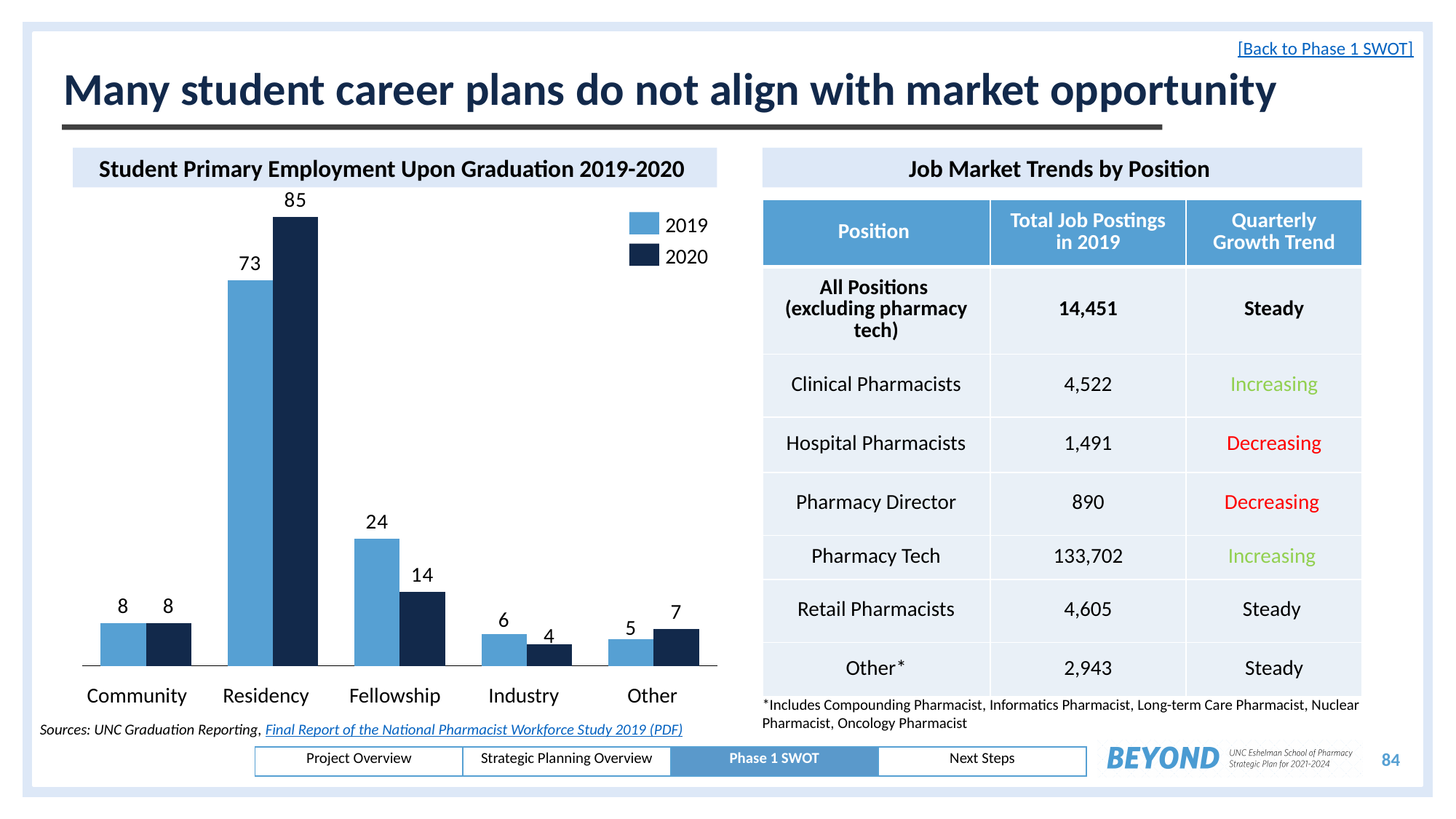
In the Student Primary Employment Upon Graduation chart, what is the difference between the 2019 and 2020 values for Fellowship? 10 Which series in the Student Primary Employment Upon Graduation chart is shown in dark navy? 2020 Which category has the highest 2019 value in the Student Primary Employment Upon Graduation chart? Residency How many series does the legend of the Student Primary Employment Upon Graduation chart list? 2 What kind of chart is the Student Primary Employment Upon Graduation chart? bar chart How many categories are shown on the x axis of the Student Primary Employment Upon Graduation chart? 5 What is the 2019 value for Fellowship in the Student Primary Employment Upon Graduation chart? 24 In the Student Primary Employment Upon Graduation chart, what is the difference between the 2020 and 2019 values for Residency? 12 What is the 2020 value for Residency in the Student Primary Employment Upon Graduation chart? 85 In the Student Primary Employment Upon Graduation chart, is the 2019 value for Other larger or smaller than the 2020 value for Other? smaller What is the 2020 value for Industry in the Student Primary Employment Upon Graduation chart? 4 Which category has the lowest 2020 value in the Student Primary Employment Upon Graduation chart? Industry